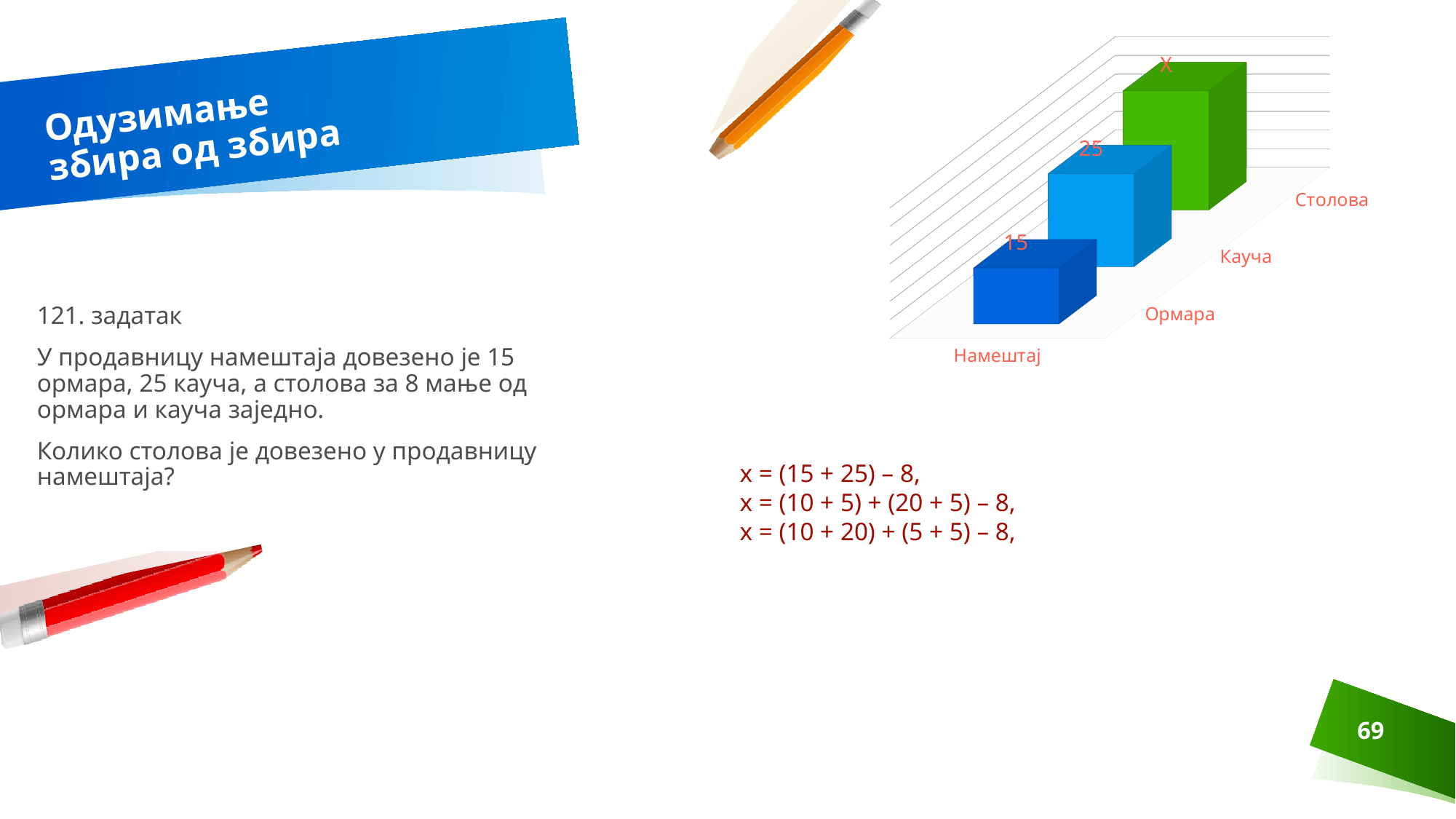
What is the difference between the values for Кауча and Ормара? 10 What value is shown for Ормара in the chart? 15 Which category has the tallest bar in the chart? Столова What colour is the bar for Столова? green Do the bars rise or fall from Ормара to Столова? rise What label is printed above the bar for Столова? x What kind of chart is shown on the slide? bar chart Which category has the shortest bar in the chart? Ормара How many categories are plotted in the chart? 3 What value is shown for Кауча in the chart? 25 Which is larger, the value for Кауча or the value for Ормара? Кауча What is the label of the category axis in the chart? Намештај